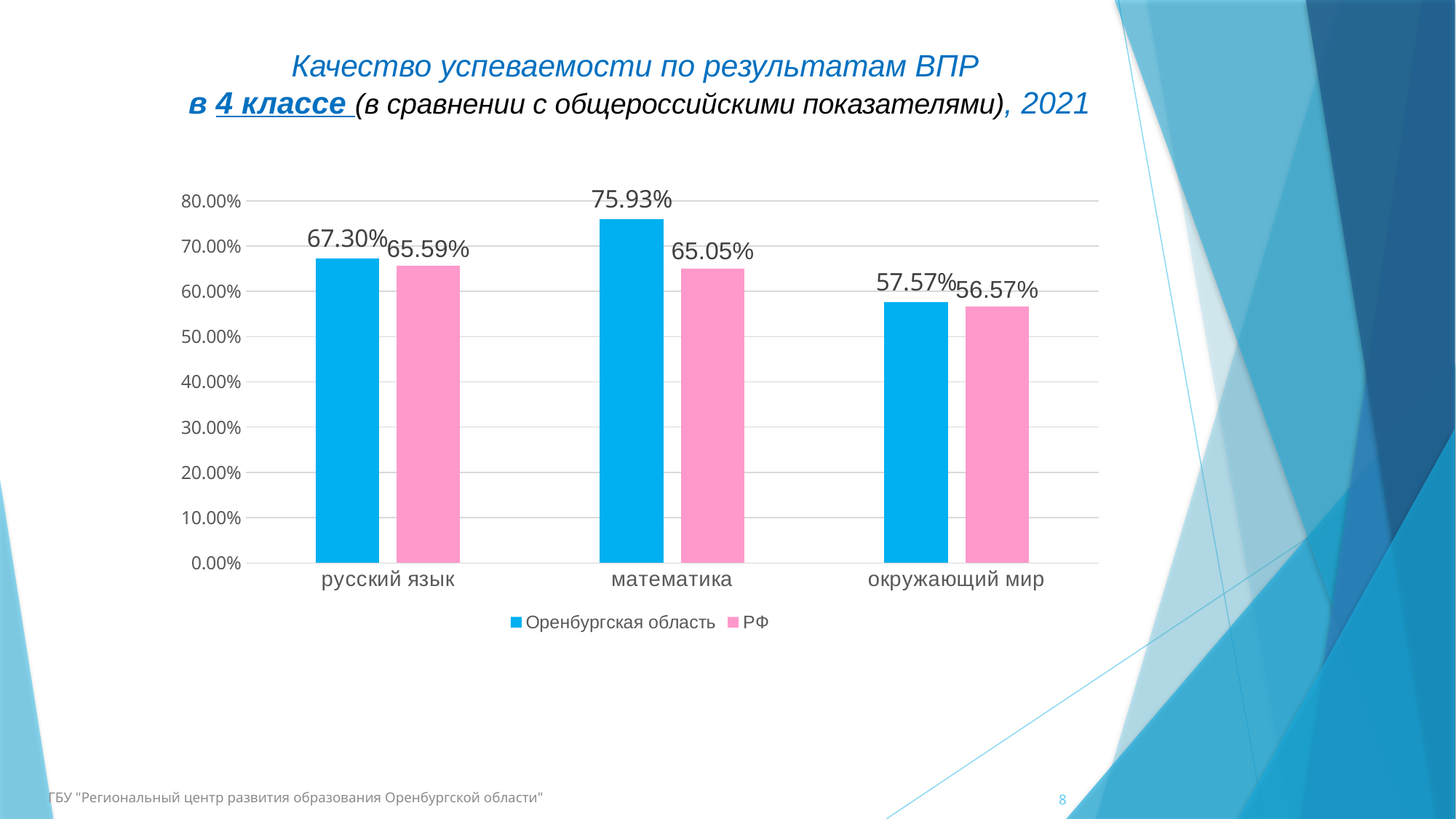
What is the difference between Оренбургская область and РФ in математика? 10.88% Is the value for Оренбургская область in русский язык greater or less than 60.00%? greater Which subject has the highest value for Оренбургская область? математика What kind of chart is shown on the slide? bar chart What is the value for РФ in окружающий мир? 56.57% How many subject categories are shown on the x axis? 3 Which is larger in окружающий мир: Оренбургская область or РФ? Оренбургская область Which subject has the lowest value for РФ? окружающий мир What is the value for Оренбургская область in математика? 75.93% What is the difference between Оренбургская область and РФ in русский язык? 1.71% What is the value for РФ in русский язык? 65.59% How many series does the legend list? 2